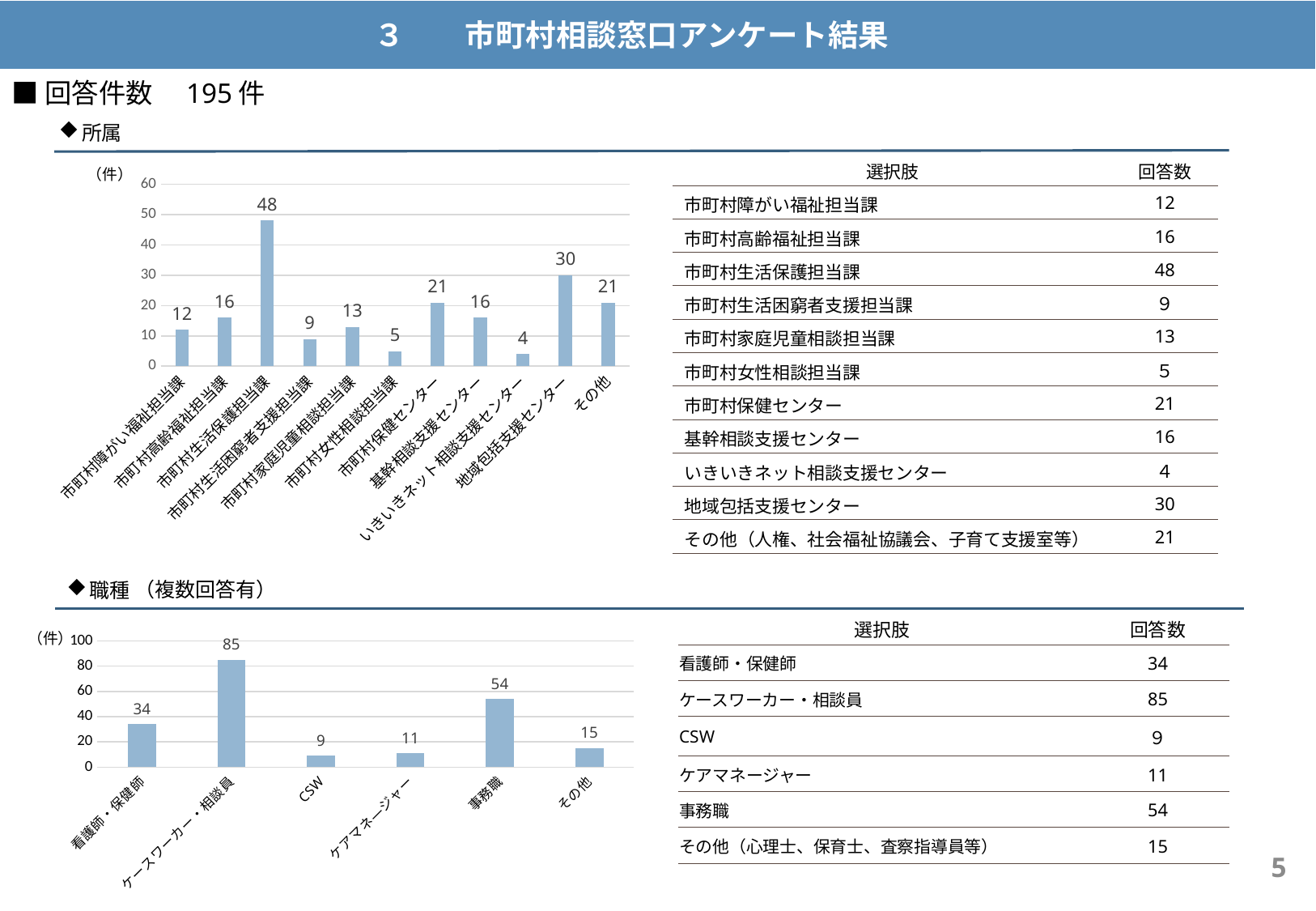
In the 所属 chart at the top, which is larger: 市町村高齢福祉担当課 or 市町村家庭児童相談担当課? 市町村高齢福祉担当課 In the 所属 chart at the top, how many categories are plotted? 11 What kind of chart is the 所属 chart at the top? bar chart In the 所属 chart at the top, which category has the lowest value? いきいきネット相談支援センター In the 所属 chart at the top, what is the difference between 地域包括支援センター and 市町村保健センター? 9 In the 職種 chart at the bottom, how many categories are plotted? 6 In the 職種 chart at the bottom, which category has the highest value? ケースワーカー・相談員 In the 所属 (affiliation) chart at the top, what is the value for 市町村生活保護担当課? 48 In the 職種 chart at the bottom, what is the value for 事務職? 54 In the 職種 chart at the bottom, which category has the lowest value? CSW In the 職種 chart at the bottom, what is the difference between ケースワーカー・相談員 and 看護師・保健師? 51 In the 所属 chart at the top, which category has the highest value? 市町村生活保護担当課